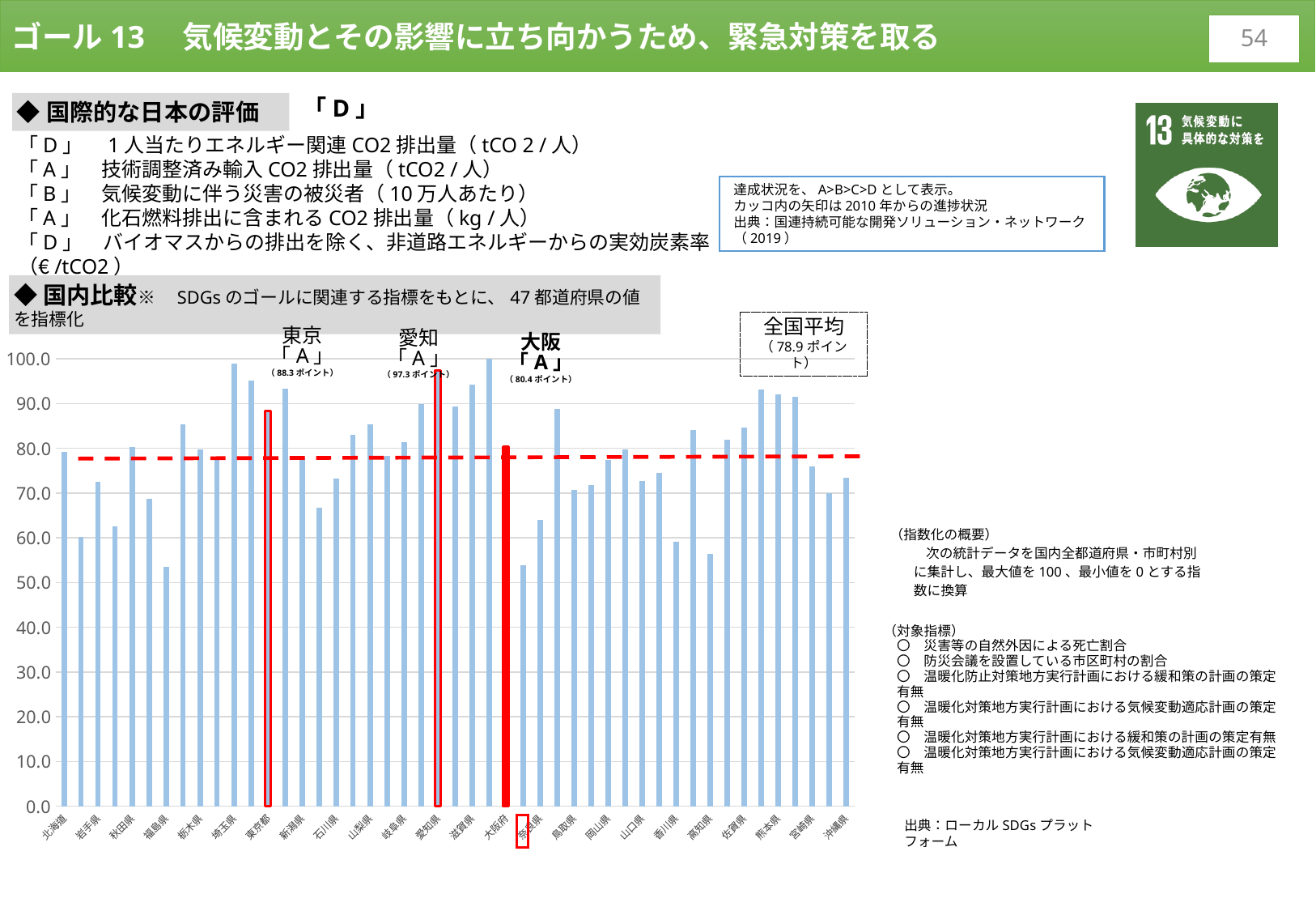
What is the difference between the value for 愛知 and the value for 大阪? 16.9 ポイント What is the value shown for 愛知 (Aichi) in the domestic comparison chart? 97.3 ポイント Which has the higher value, 愛知 or 東京? 愛知 What is the value shown for 東京 (Tokyo) in the domestic comparison chart? 88.3 ポイント What is the 全国平均 (national average) value shown on the chart? 78.9 ポイント Which has the higher value, 東京 or 大阪? 東京 What does the red dashed horizontal line on the chart represent? 全国平均 (78.9 ポイント) What is the value shown for 大阪 (Osaka) in the domestic comparison chart? 80.4 ポイント Is the value for 愛知 greater or less than 90.0? greater What kind of chart is used for the domestic comparison? bar chart What is the difference between the values for 愛知 and 東京? 9.0 ポイント What is the difference between the value for 東京 and the 全国平均? 9.4 ポイント